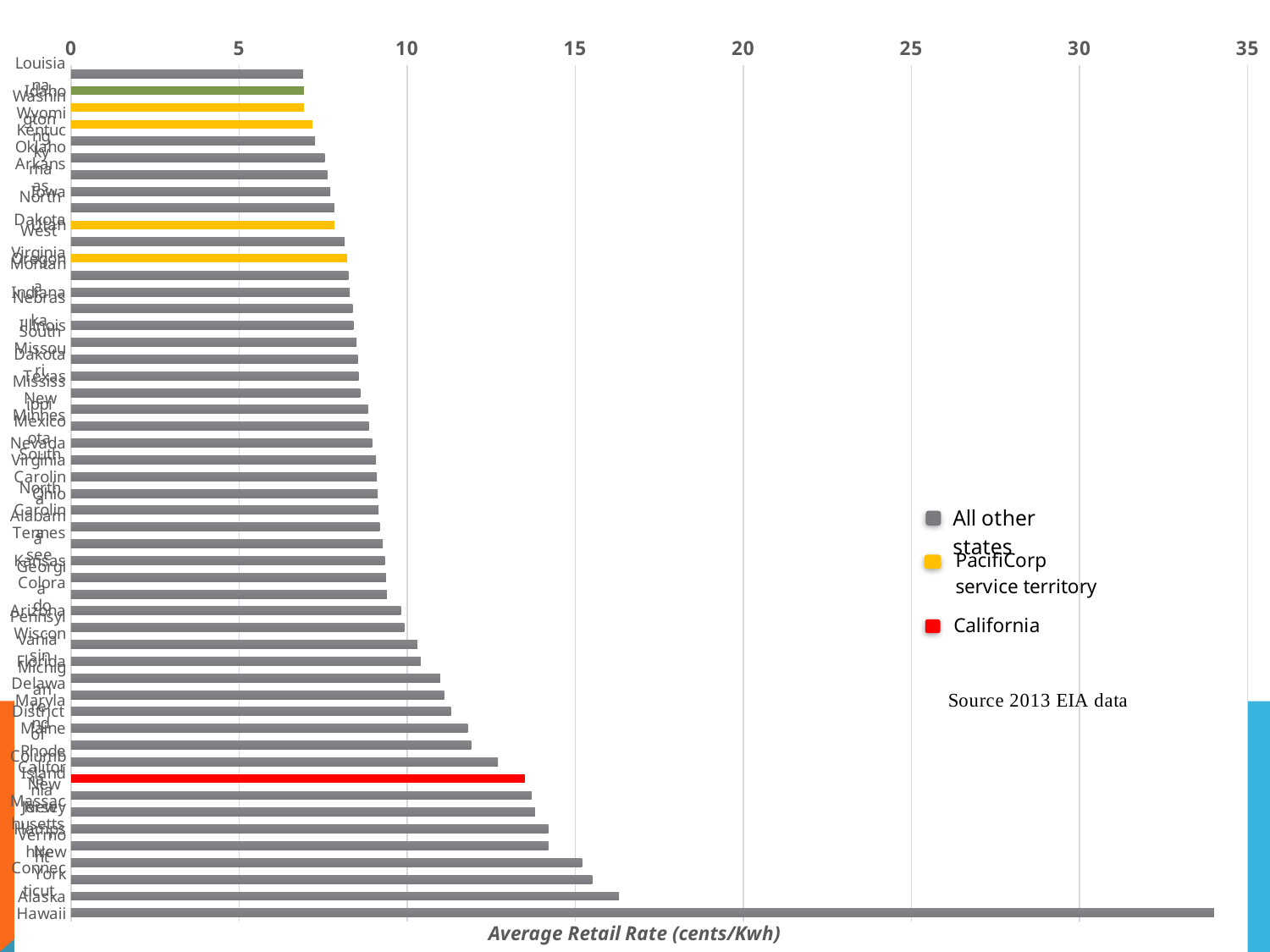
What kind of chart is shown on the slide? Bar chart Which has a higher average retail rate, Hawaii or Alaska? Hawaii Is the value for Louisiana greater or less than 10? less Is the value for Hawaii greater or less than 30? greater What is the title of the horizontal axis? Average Retail Rate (cents/Kwh) Is the value for California greater or less than 15? less How many series does the legend list? 3 Which has a higher average retail rate, Alaska or California? Alaska What colour is the bar for California? Red Which state has the highest average retail rate? Hawaii